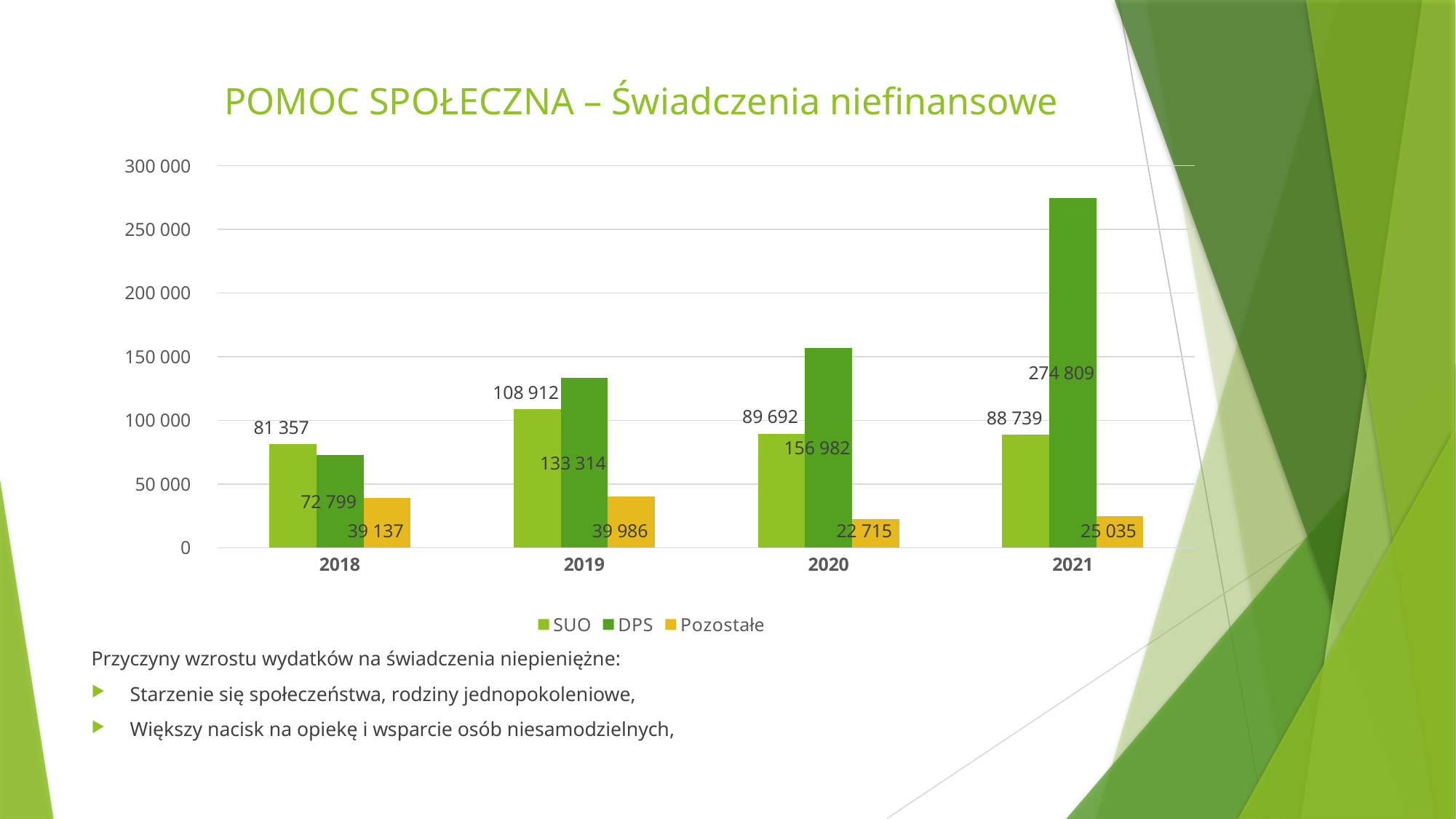
How many years are shown on the x axis? 4 In which year is the DPS value highest? 2021 What is the value for DPS in 2021? 274 809 In which year is the Pozostałe value lowest? 2020 How many series does the legend list? 3 What kind of chart is shown on the slide? bar chart What is the value for Pozostałe in 2020? 22 715 Is the value for DPS in 2020 greater or less than 150 000? greater Does the DPS value rise or fall from 2018 to 2021? rise Which is larger in 2018, SUO or DPS? SUO What is the difference between the DPS values in 2021 and 2020? 117 827 What is the value for SUO in 2019? 108 912